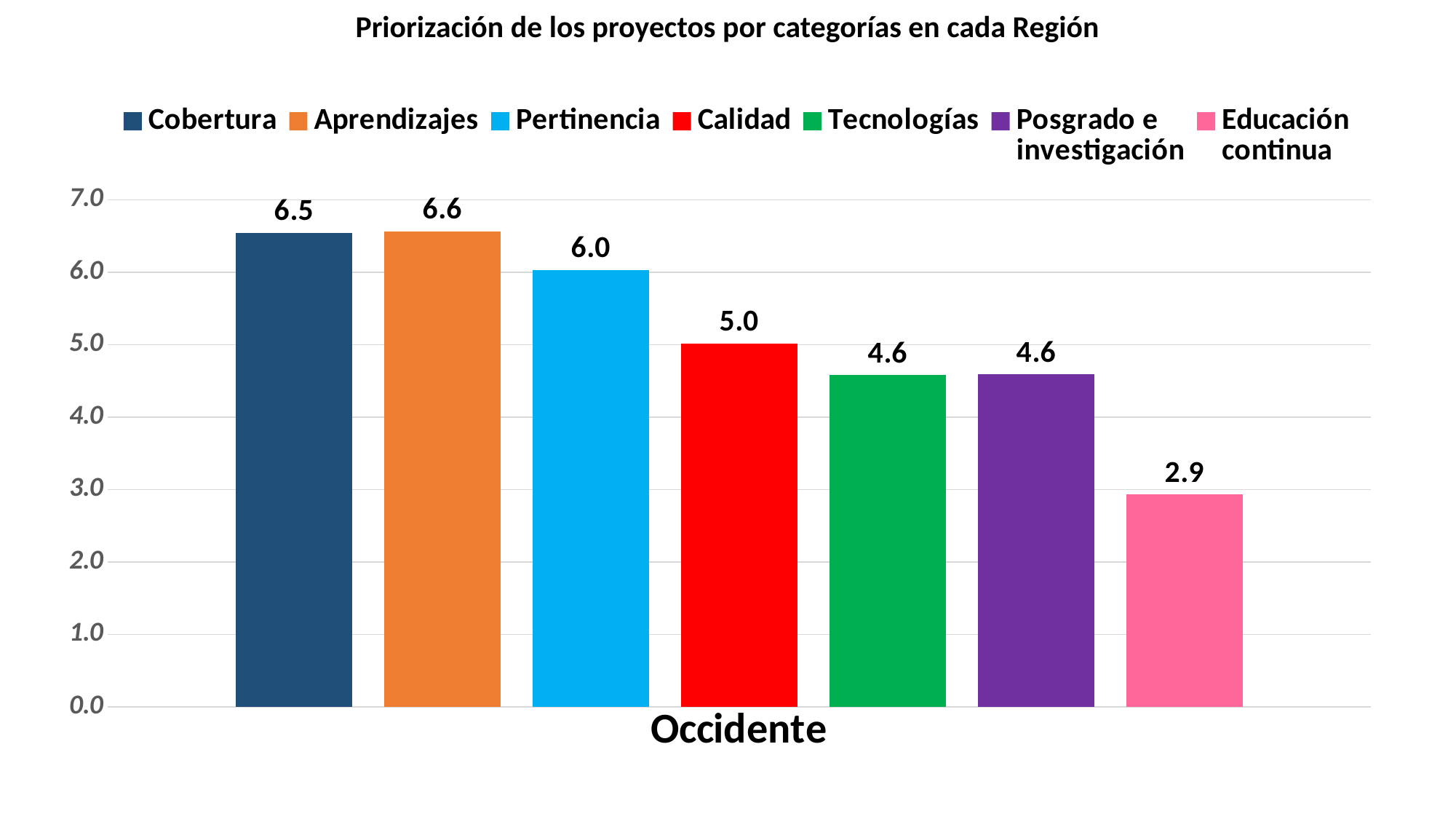
Which series has the lowest value? Educación continua Which is larger, the value for Pertinencia or the value for Tecnologías? Pertinencia Is the value for Posgrado e investigación greater or less than 4.0? greater What is the difference between the values for Pertinencia and Calidad? 1.0 What is the difference between the values for Aprendizajes and Educación continua? 3.7 What is the title of the chart? Priorización de los proyectos por categorías en cada Región How many series does the legend list? 7 What is the value for Cobertura in the Occidente region? 6.5 What kind of chart is shown on the slide? Bar chart Which series has the highest value? Aprendizajes What is the value for Calidad? 5.0 What is the value for Educación continua? 2.9